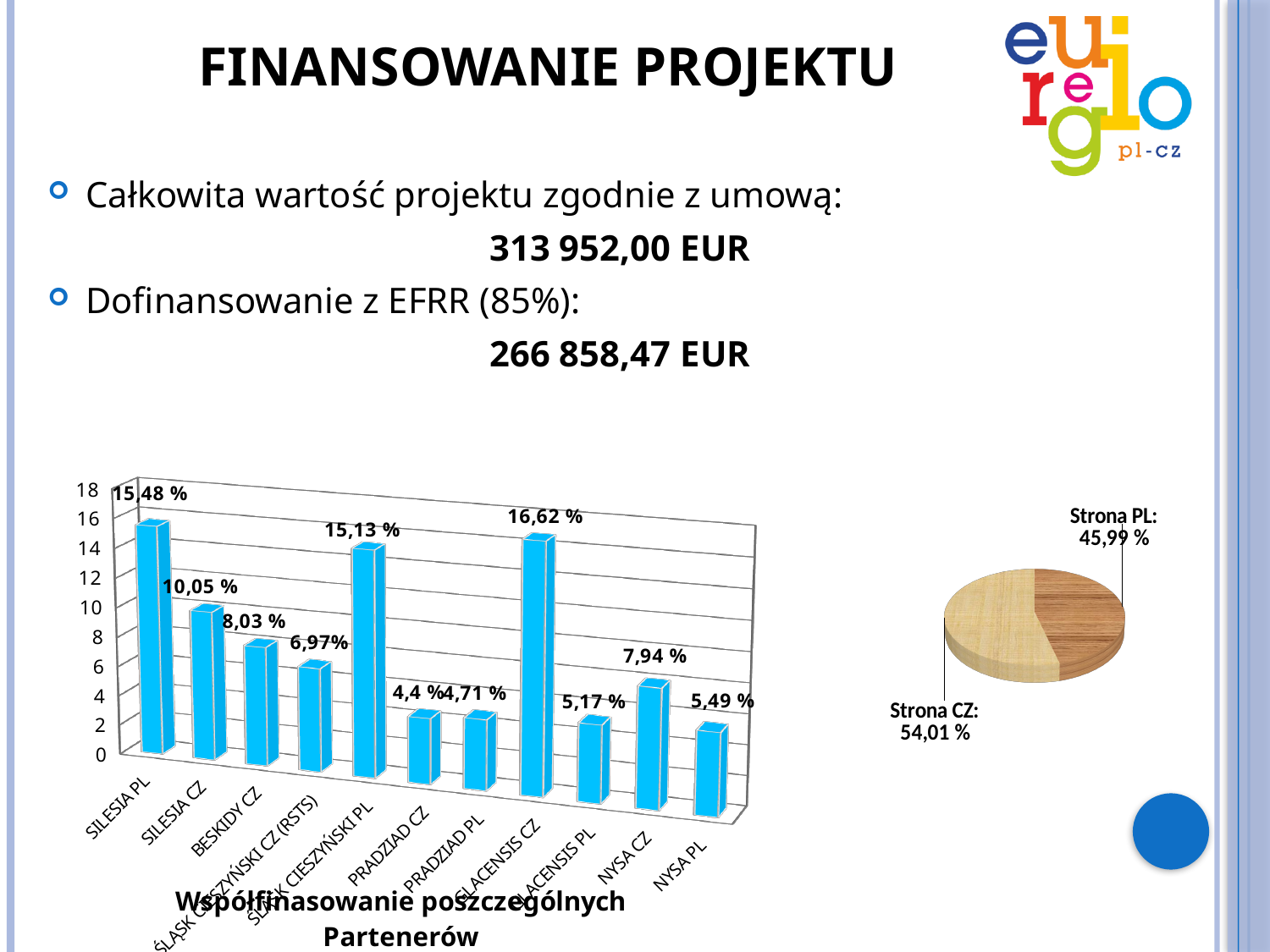
In the pie chart, what is the share for Strona CZ? 54,01 % In the bar chart, what is the value for PRADZIAD PL? 4,71 % In the bar chart, which is larger, NYSA CZ or NYSA PL? NYSA CZ In the pie chart, what is the share for Strona PL? 45,99 % In the bar chart, what is the difference between SILESIA PL and SILESIA CZ? 5,43 % In the bar chart, which category has the highest value? GLACENSIS CZ What type of chart is the chart on the left of the slide? bar chart In the bar chart, what is the value for BESKIDY CZ? 8,03 % In the bar chart, what is the value for SILESIA PL? 15,48 % How many bars are shown in the bar chart? 11 In the bar chart, which category has the lowest value? PRADZIAD CZ In the bar chart, what is the value for NYSA CZ? 7,94 %